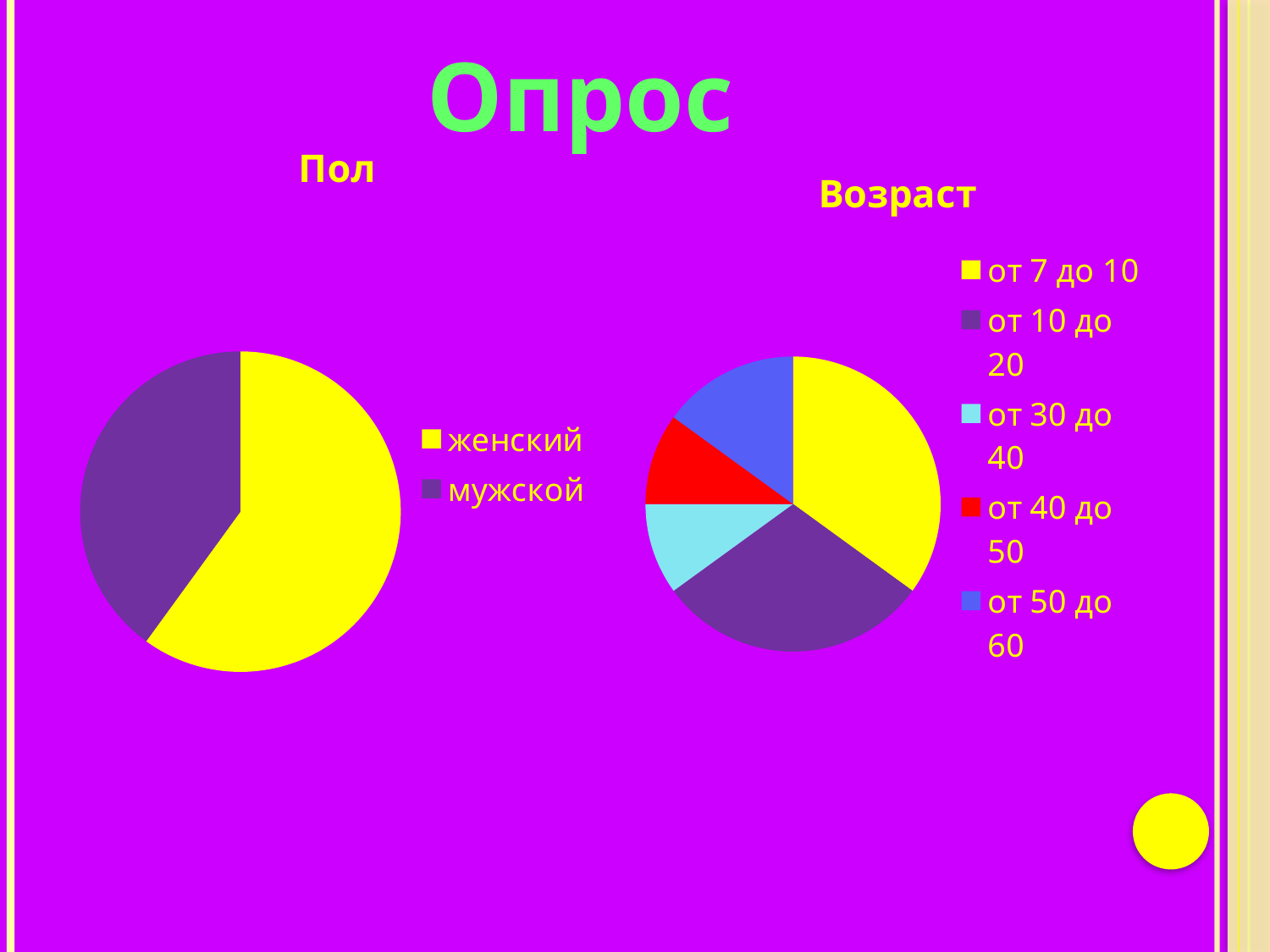
In the "Возраст" chart, which slice is larger, от 7 до 10 or от 30 до 40? от 7 до 10 What colour is the slice for от 40 до 50 in the "Возраст" chart? red How many entries does the legend of the "Возраст" chart list? 5 In the "Возраст" chart, which age group has the largest slice? от 7 до 10 In the "Возраст" chart, which slice is larger, от 10 до 20 or от 40 до 50? от 10 до 20 In the "Пол" chart, which slice is larger, женский or мужской? женский What kind of chart is the "Возраст" chart? pie chart What is the title of the chart on the left of the slide? Пол How many categories does the "Пол" chart show? 2 What kind of chart is the "Пол" chart? pie chart In the "Пол" chart, which category has the largest slice? женский In the "Пол" chart, which category has the smallest slice? мужской